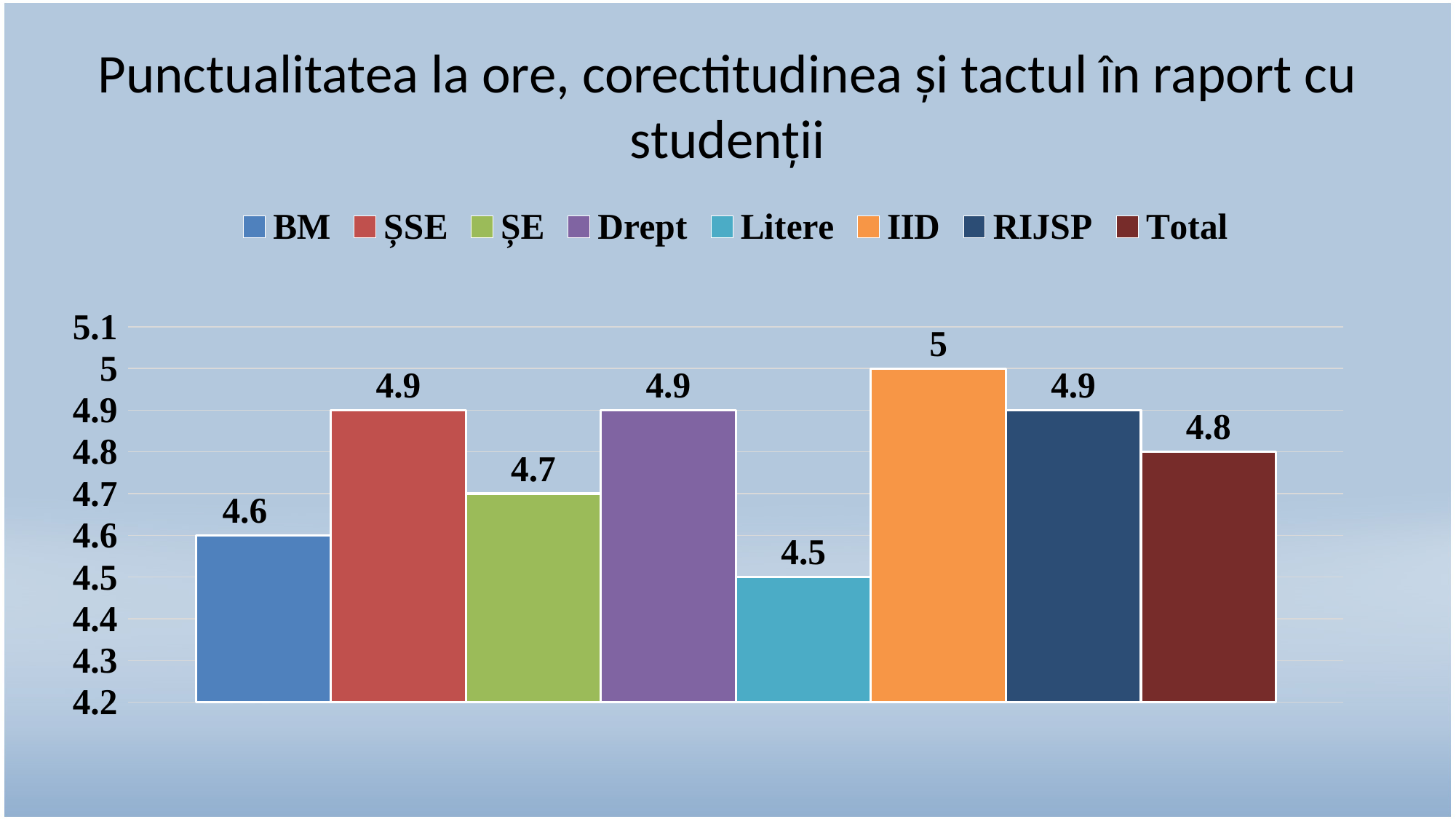
What is the value for IID? 5 What is the value for BM? 4.6 What is the value for Total? 4.8 What is the title of the chart? Punctualitatea la ore, corectitudinea și tactul în raport cu studenții What kind of chart is shown on the slide? bar chart What is the difference between the values for IID and Litere? 0.5 What is the value for Litere? 4.5 How many series does the legend list? 8 Which series has the lowest value? Litere Which is larger, the value for ȘE or the value for Drept? Drept Is the value for ȘSE greater or less than 4.8? greater Which series has the highest value? IID